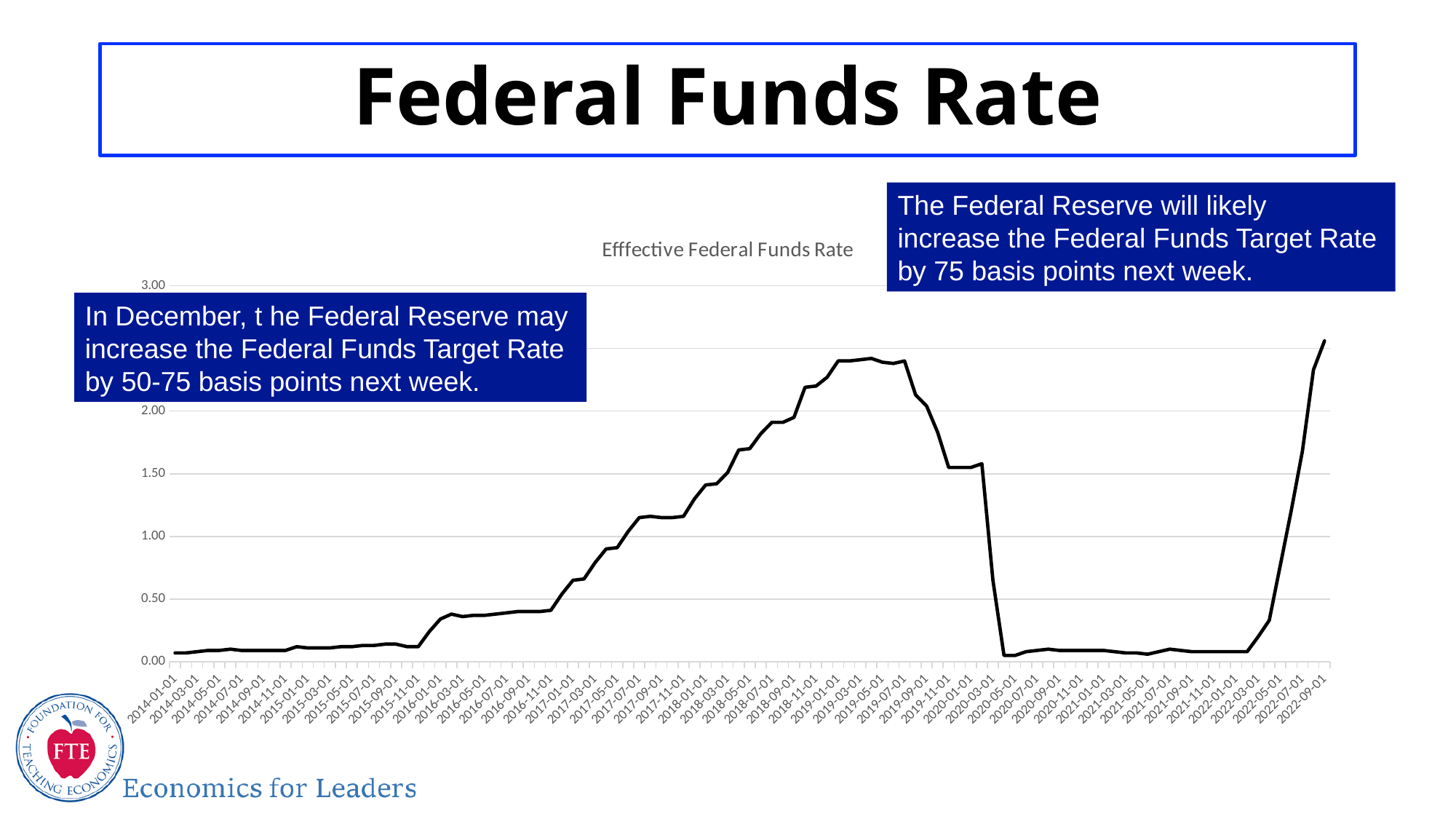
Is the value for 2018-01-01 greater or less than 1.00? greater Is the value for 2020-05-01 greater or less than 0.50? less Is the value for 2014-01-01 greater or less than 0.50? less Does the line rise or fall between 2019-07-01 and 2020-05-01? fall Which is larger, the value for 2019-03-01 or the value for 2020-05-01? 2019-03-01 What is the title of the chart? Efffective Federal Funds Rate Does the line rise or fall between 2016-01-01 and 2019-03-01? rise What kind of chart is shown on the slide? line chart What is the highest value shown on the chart's vertical axis? 3.00